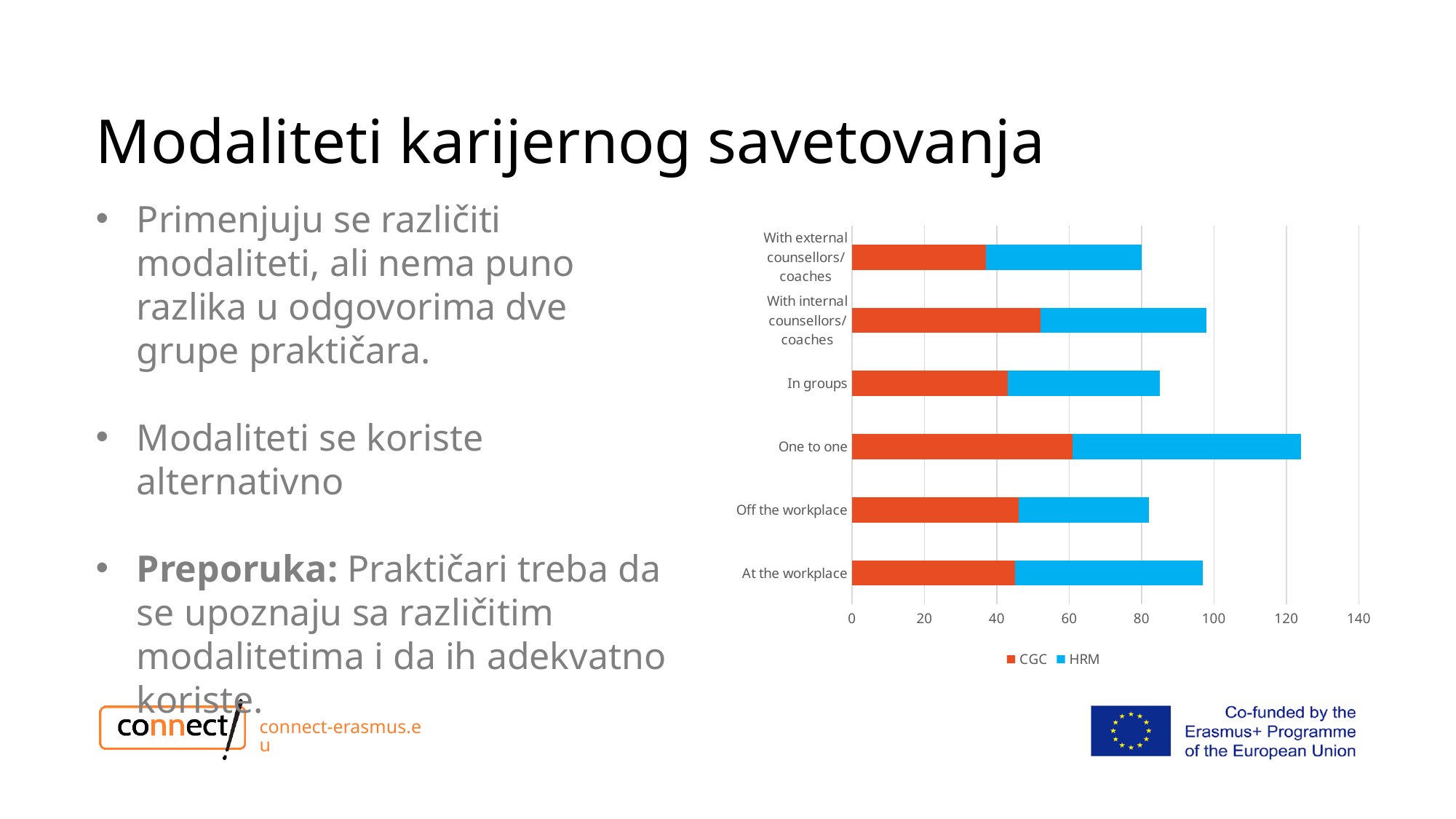
Is the total value for At the workplace greater or less than 80? greater Which series is shown in blue in the chart legend? HRM Is the total value for Off the workplace greater or less than 100? less Which category has the highest total bar length? One to one Is the total value for One to one greater or less than 100? greater Which has a larger CGC segment: One to one or With external counsellors/coaches? One to one Which has a larger total bar: One to one or In groups? One to one How many categories are plotted on the chart? 6 How many series does the chart legend list? 2 What kind of chart is shown on the slide? Stacked bar chart Which category has the largest CGC segment? One to one